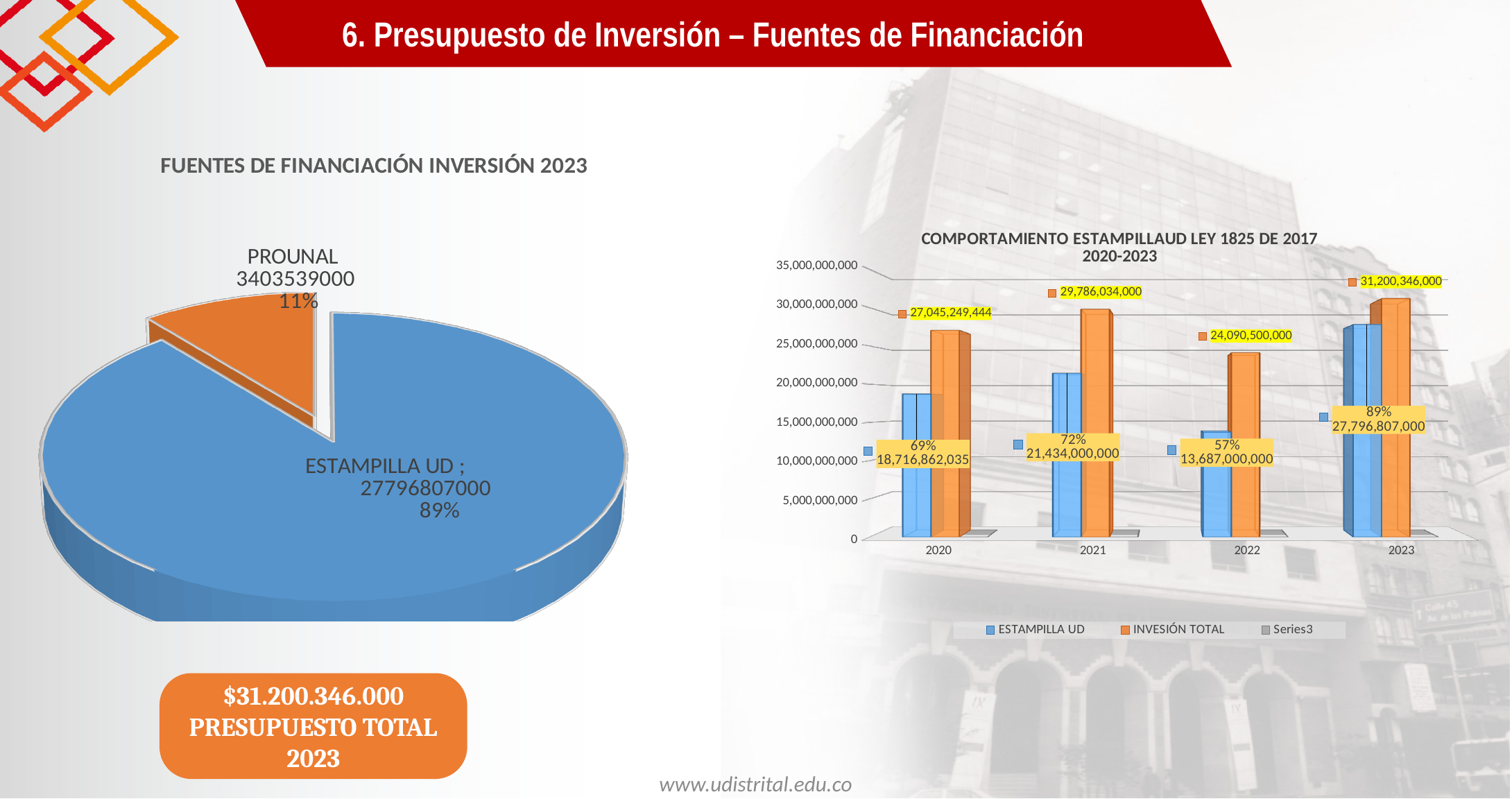
In the bar chart 'COMPORTAMIENTO ESTAMPILLAUD LEY 1825 DE 2017 2020-2023', what is the INVESIÓN TOTAL value for 2021? 29,786,034,000 In the pie chart 'FUENTES DE FINANCIACIÓN INVERSIÓN 2023', what value is shown for PROUNAL? 3403539000 How many slices does the pie chart 'FUENTES DE FINANCIACIÓN INVERSIÓN 2023' have? 2 In the bar chart 'COMPORTAMIENTO ESTAMPILLAUD LEY 1825 DE 2017 2020-2023', which year has the highest INVESIÓN TOTAL value? 2023 In the bar chart 'COMPORTAMIENTO ESTAMPILLAUD LEY 1825 DE 2017 2020-2023', what percentage label is shown for ESTAMPILLA UD in 2021? 72% In the bar chart 'COMPORTAMIENTO ESTAMPILLAUD LEY 1825 DE 2017 2020-2023', which year has the lowest ESTAMPILLA UD value? 2022 In the pie chart 'FUENTES DE FINANCIACIÓN INVERSIÓN 2023', which slice is the largest? ESTAMPILLA UD In the bar chart 'COMPORTAMIENTO ESTAMPILLAUD LEY 1825 DE 2017 2020-2023', what is the difference between INVESIÓN TOTAL and ESTAMPILLA UD in 2023? 3,403,539,000 In the pie chart 'FUENTES DE FINANCIACIÓN INVERSIÓN 2023', what share does ESTAMPILLA UD represent? 89% In the bar chart 'COMPORTAMIENTO ESTAMPILLAUD LEY 1825 DE 2017 2020-2023', what is the ESTAMPILLA UD value for 2022? 13,687,000,000 What kind of chart is the chart on the left of the slide? Pie chart How many series does the legend of the bar chart 'COMPORTAMIENTO ESTAMPILLAUD LEY 1825 DE 2017 2020-2023' list? 3